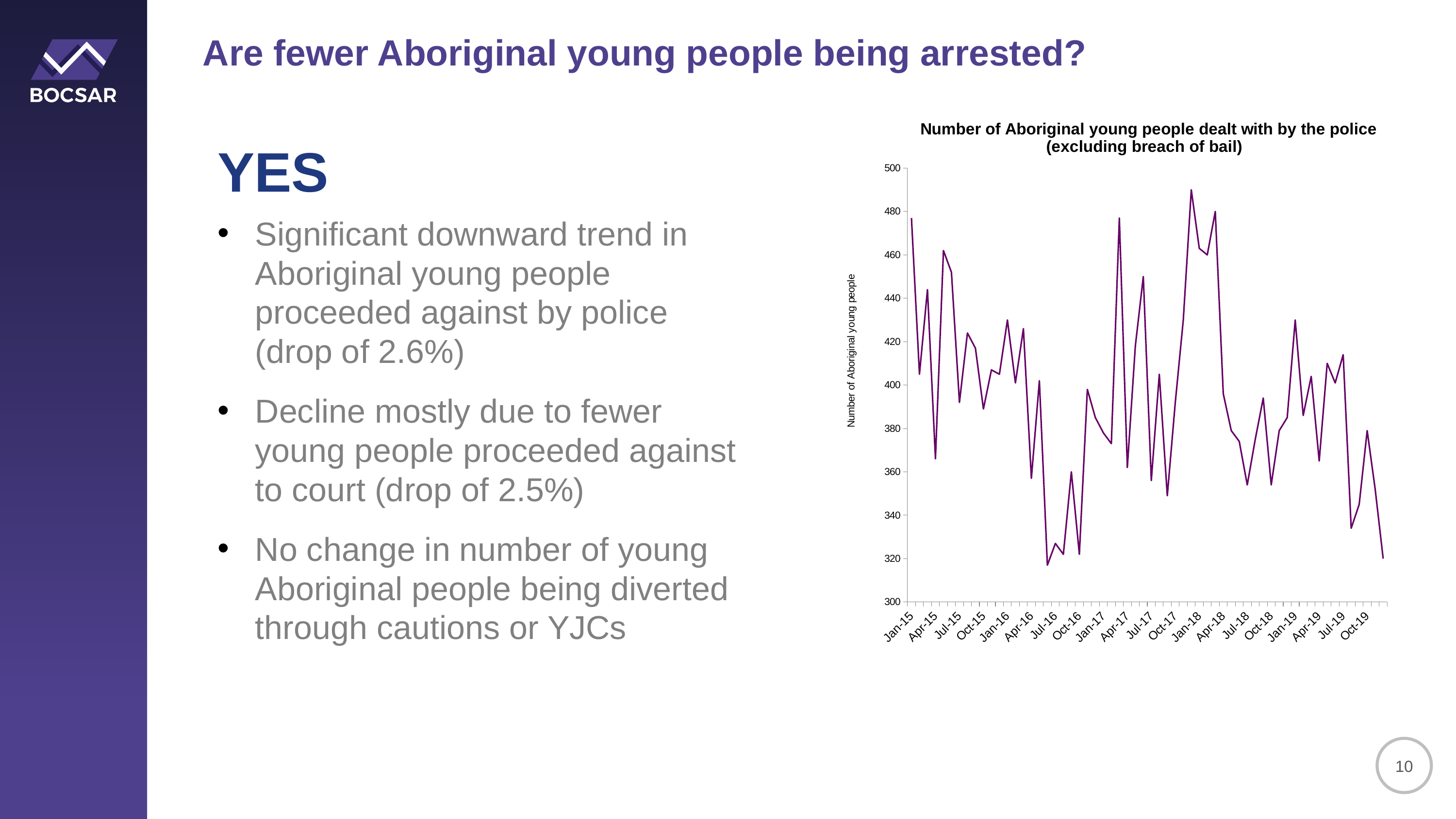
What is the label on the vertical axis of the chart? Number of Aboriginal young people Is the highest point on the chart greater or less than 480? greater Is the value for Apr-17 greater or less than 440? less What kind of chart is shown on the slide? line chart Is the value for Jan-18 greater or less than 440? greater Which is larger, the value for Jan-18 or the value for Oct-19? Jan-18 Overall, do the values rise or fall from Jan-15 to the end of the series? fall Which is larger, the value for Jan-15 or the value for Jul-16? Jan-15 What is the title of the chart? Number of Aboriginal young people dealt with by the police (excluding breach of bail) How many lines (series) are plotted on the chart? 1